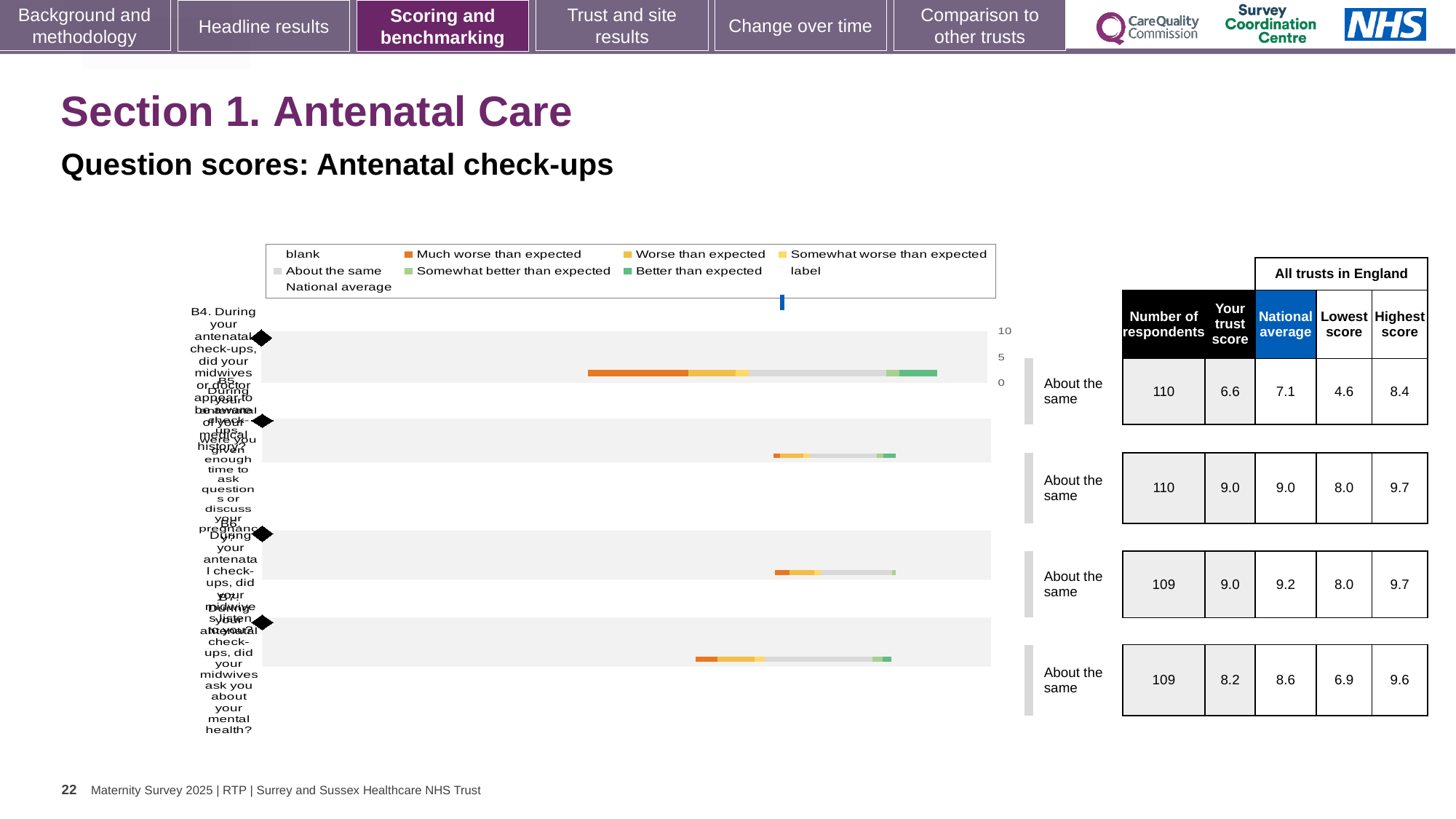
What is the difference between the National average and 'Your trust score' in the first row (B4)? 0.5 In the last row (B7), which is larger: 'Your trust score' or the National average? National average According to the table, what is the Highest score for the last row (question B7)? 9.6 According to the table, what is the National average for the first row (question B4)? 7.1 What is the subtitle of the chart section on the slide? Question scores: Antenatal check-ups Which row in the table has the lowest 'Your trust score'? the first row (B4), 6.6 According to the table, what is the 'Your trust score' for the first row (question B4)? 6.6 How many question bars (categories) are plotted in the chart? 4 According to the table, what is the Lowest score for the first row (question B4)? 4.6 According to the table, how many respondents are there for the last row (question B7)? 109 What kind of chart is shown on the slide? bar chart What benchmark category label is shown next to each of the four bars? About the same